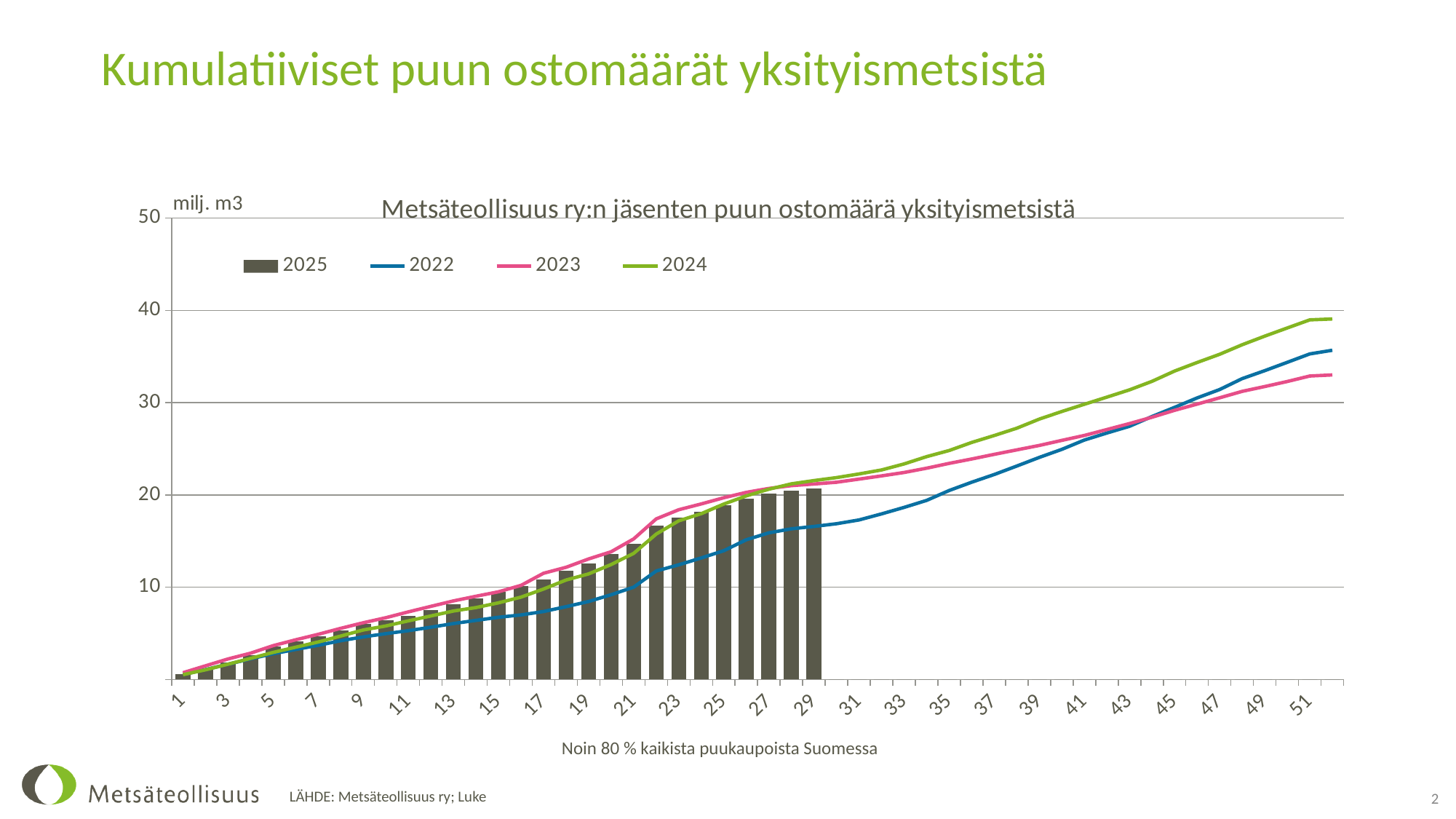
How many series does the chart legend list? 4 What is the title of the chart? Metsäteollisuus ry:n jäsenten puun ostomäärä yksityismetsistä Is the value of the 2025 bar at week 21 greater or less than 20? less At week 51, which is larger: the 2024 line or the 2023 line? 2024 Which series is plotted as bars rather than a line? 2025 Is the value of the 2024 line at week 51 greater or less than 30? greater Do the values of the 2024 line rise or fall along the x axis? Rise At week 29, which is larger: the 2022 line or the 2023 line? 2023 Which series has the highest value at the right end of the chart (week 51)? 2024 Is the value of the 2022 line at week 31 greater or less than 20? less Which series has the lowest value at the right end of the chart (week 51)? 2023 What kind of chart is shown on the slide? Combined bar and line chart